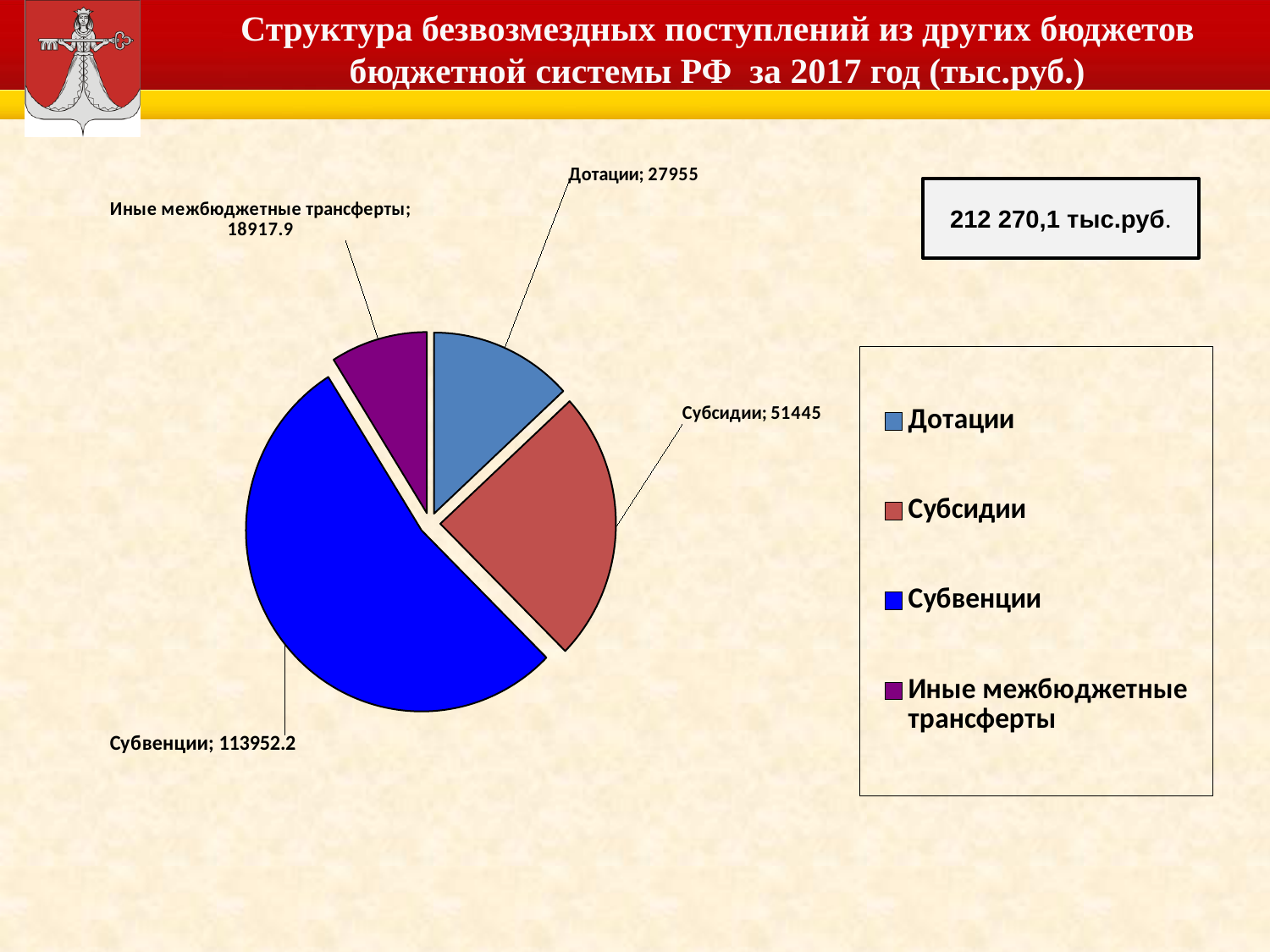
What colour is the Субвенции slice in the pie chart? blue How many slices does the pie chart have? 4 Which category has the smallest slice of the pie? Иные межбюджетные трансферты What is the value for Иные межбюджетные трансферты? 18917.9 What is the value for Субсидии? 51445 Which category has the largest slice of the pie? Субвенции How many entries does the legend list? 4 What is the value for Субвенции? 113952.2 What type of chart is shown on the slide? pie chart Which is larger, Дотации or Субсидии? Субсидии What is the value for Дотации? 27955 What is the difference between the values for Субвенции and Субсидии? 62507.2